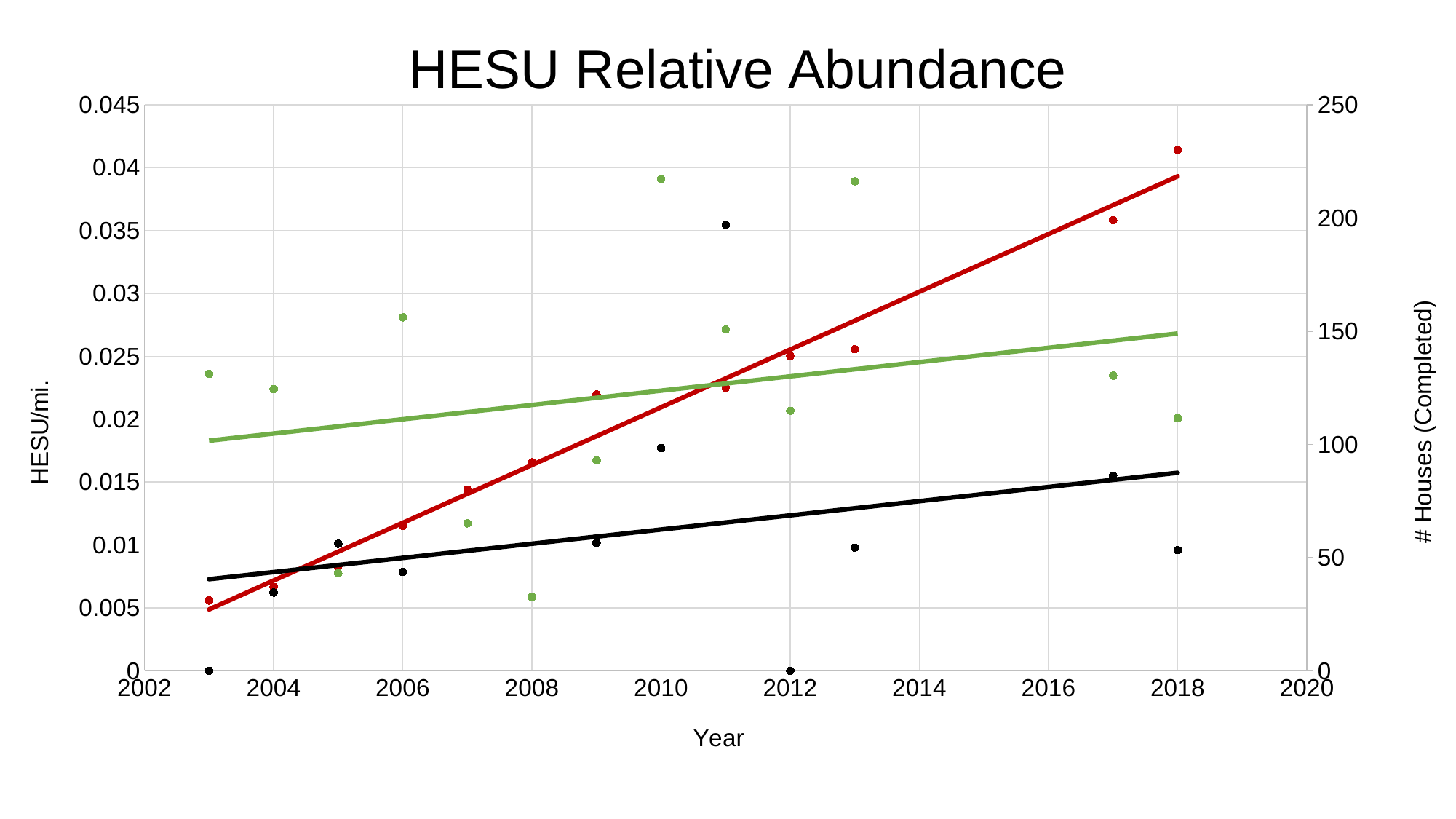
Is the red point for 2018 greater or less than 0.04 on the left axis scale? greater Does the black trend line rise or fall across the years? rises In which year is the red series at its highest point? 2018 What is the title of the right-hand vertical axis? # Houses (Completed) In which year is the red series at its lowest point? 2003 Which is higher, the green point for 2010 or the green point for 2008? 2010 What kind of chart is shown on the slide? scatter chart How many differently coloured series are plotted on the chart? 3 Does the red trend line rise or fall from 2003 to 2018? rises Does the green trend line rise or fall across the years? rises What is the title of the chart? HESU Relative Abundance In which year is the black series at its highest point? 2011